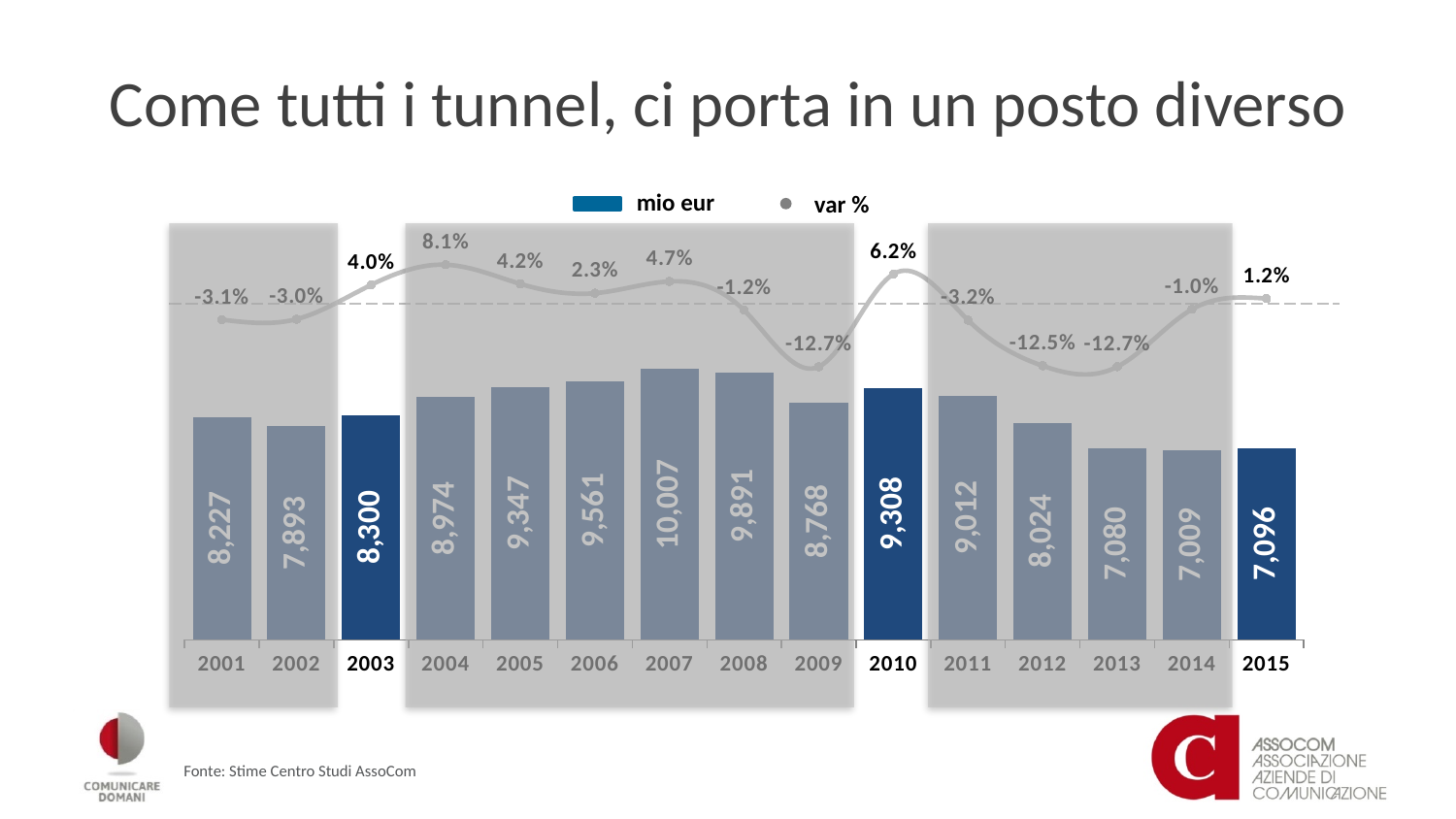
How many years are shown on the x axis? 15 Do the mio eur values rise or fall from 2011 to 2014? fall Which year has the highest mio eur value? 2007 Which is larger, the mio eur value for 2003 or for 2012? 2003 Which year has the highest var % value? 2004 How many series does the legend list? 2 What is the mio eur value for 2015? 7,096 What is the mio eur value for 2007? 10,007 What is the difference in mio eur between 2010 and 2009? 540 What is the var % value for 2010? 6.2% Which year has the lowest mio eur value? 2014 What is the var % value for 2004? 8.1%